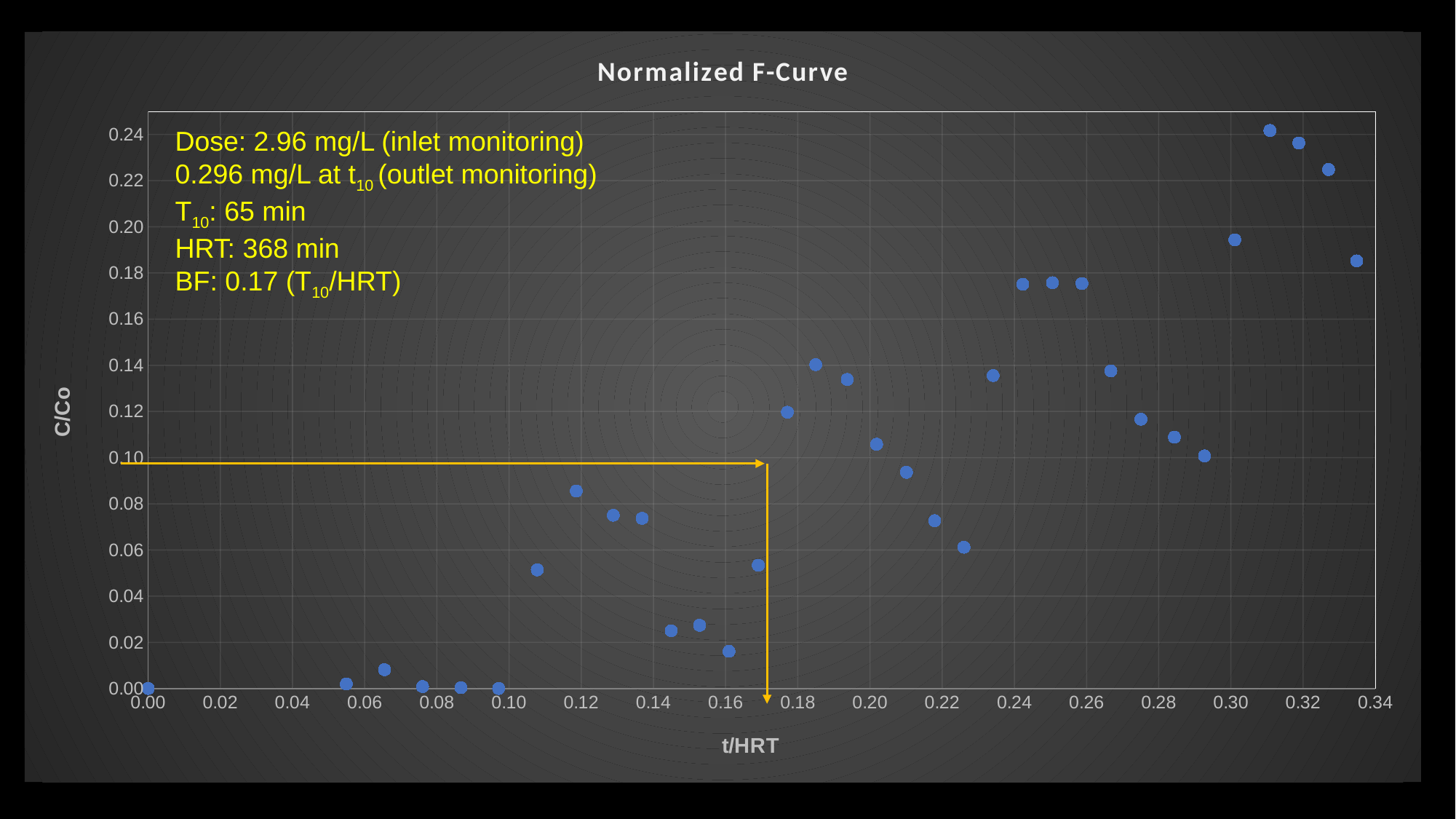
What kind of chart is shown on the slide? scatter chart Is the C/Co value of the point near t/HRT 0.16 greater or less than 0.04? less Is the C/Co value of the point near t/HRT 0.22 greater or less than 0.06? greater Overall, do the C/Co values rise or fall as t/HRT increases from 0.00 to 0.34? rise What is the C/Co value of the point at t/HRT = 0.00? 0.00 What are the labels of the x axis and the y axis of the chart? t/HRT and C/Co Is the C/Co value of the point near t/HRT 0.12 greater or less than 0.10? less Which point has the larger C/Co value: the one near t/HRT 0.17 or the one near t/HRT 0.18? the one near t/HRT 0.18 What is the title of the chart? Normalized F-Curve